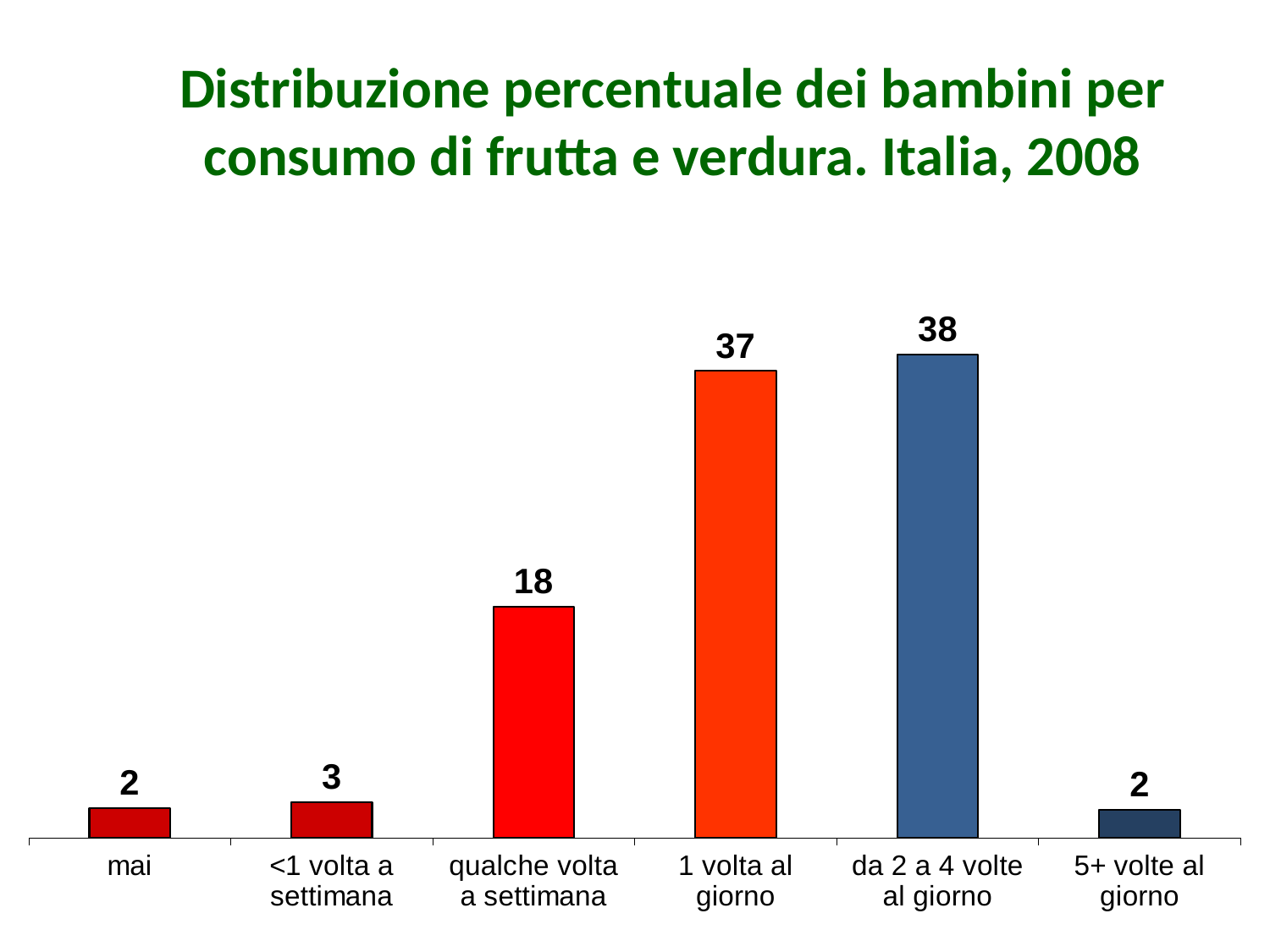
Which is larger, the value for "qualche volta a settimana" or the value for "<1 volta a settimana"? qualche volta a settimana How many categories are shown on the x axis? 6 What is the difference between the values for "da 2 a 4 volte al giorno" and "1 volta al giorno"? 1 What is the value for "qualche volta a settimana"? 18 What is the difference between the values for "1 volta al giorno" and "qualche volta a settimana"? 19 What is the value for "5+ volte al giorno"? 2 Which category has the highest value? da 2 a 4 volte al giorno What is the value for "<1 volta a settimana"? 3 What is the title of the chart? Distribuzione percentuale dei bambini per consumo di frutta e verdura. Italia, 2008 What type of chart is shown on the slide? bar chart What is the value for "1 volta al giorno"? 37 What is the value for "mai"? 2